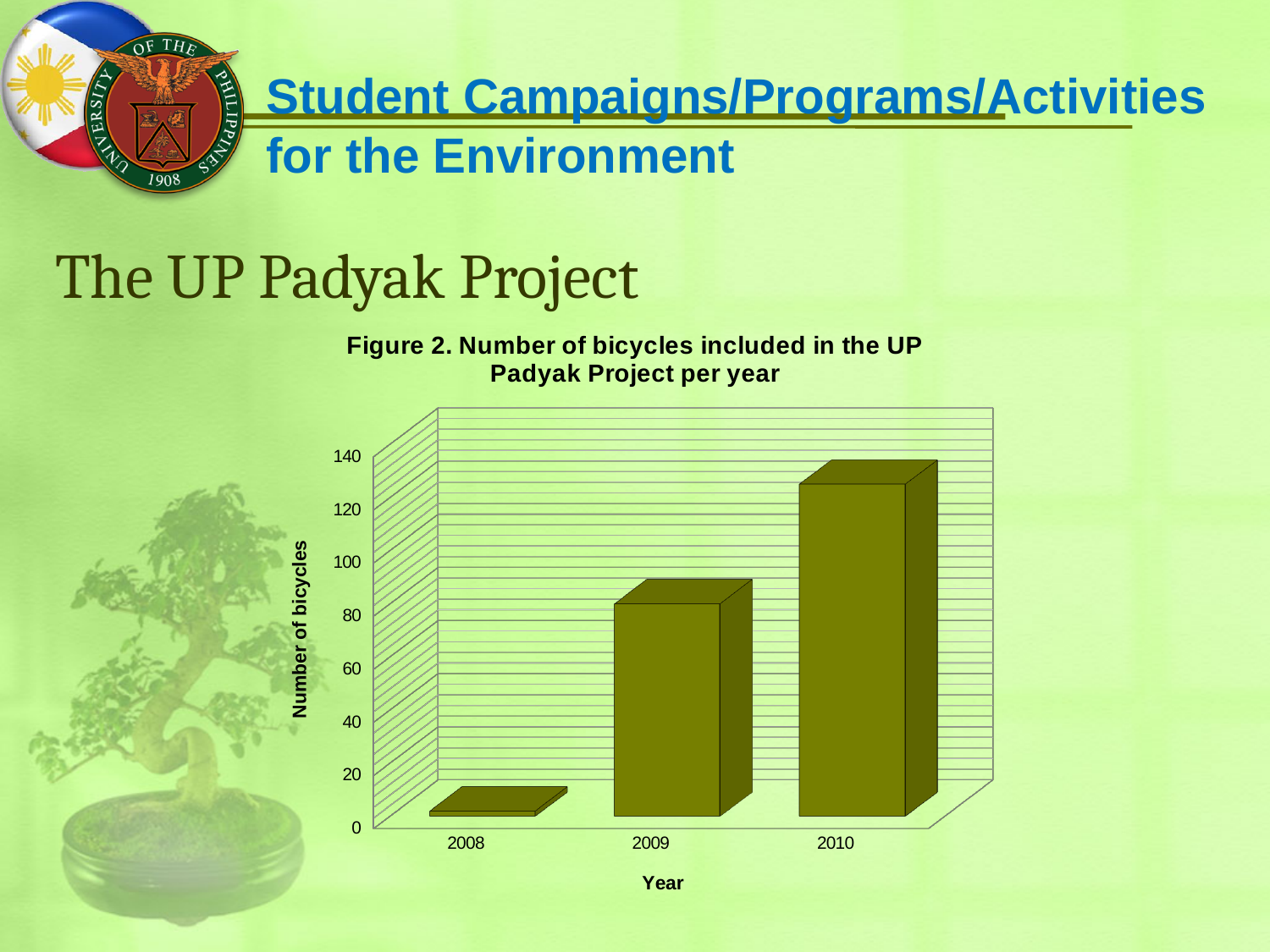
What kind of chart is shown on the slide? bar chart What is the label of the vertical axis of the chart? Number of bicycles Which year has fewer bicycles, 2008 or 2009? 2008 Do the values rise or fall from 2008 to 2010? rise Which year has more bicycles, 2009 or 2010? 2010 Which year has the highest number of bicycles? 2010 Is the value for 2009 greater or less than 100? less Which year has the lowest number of bicycles? 2008 How many years are plotted in the chart? 3 Is the value for 2008 greater or less than 20? less Is the value for 2009 greater or less than 60? greater